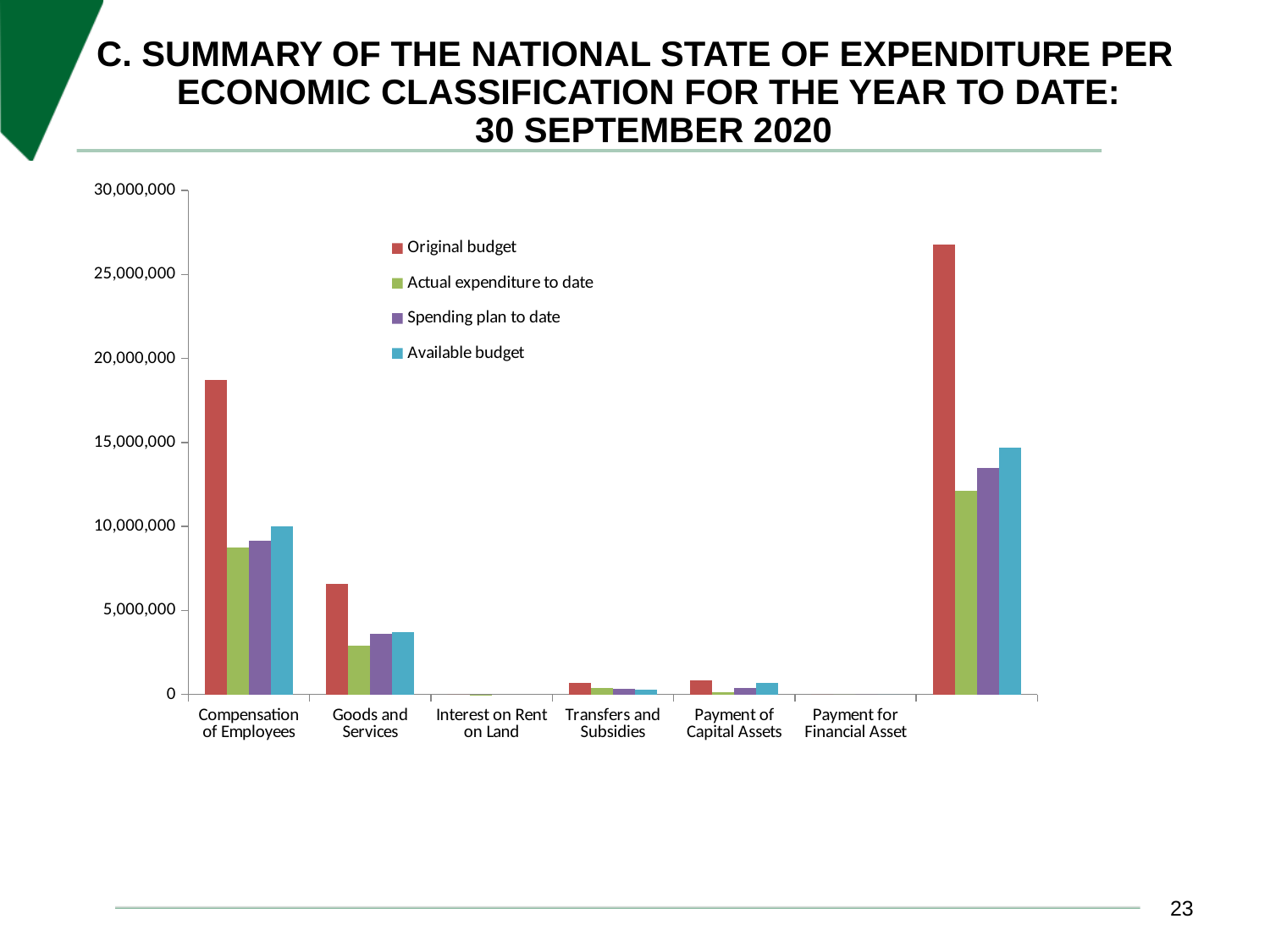
Is the Original budget value for Compensation of Employees greater or less than 15,000,000? greater Which series is listed first in the legend? Original budget For Goods and Services, which is larger: the Original budget or the Actual expenditure to date? Original budget How many category labels are shown on the x axis? 6 How many series does the legend list? 4 What colour represents the Available budget series? blue Is the Actual expenditure to date value for Goods and Services greater or less than 5,000,000? less Is the Original budget value for Goods and Services greater or less than 5,000,000? greater What kind of chart is shown on the slide? bar chart For Compensation of Employees, which is larger: the Available budget or the Spending plan to date? Available budget Among the labelled categories, which has the highest Original budget? Compensation of Employees